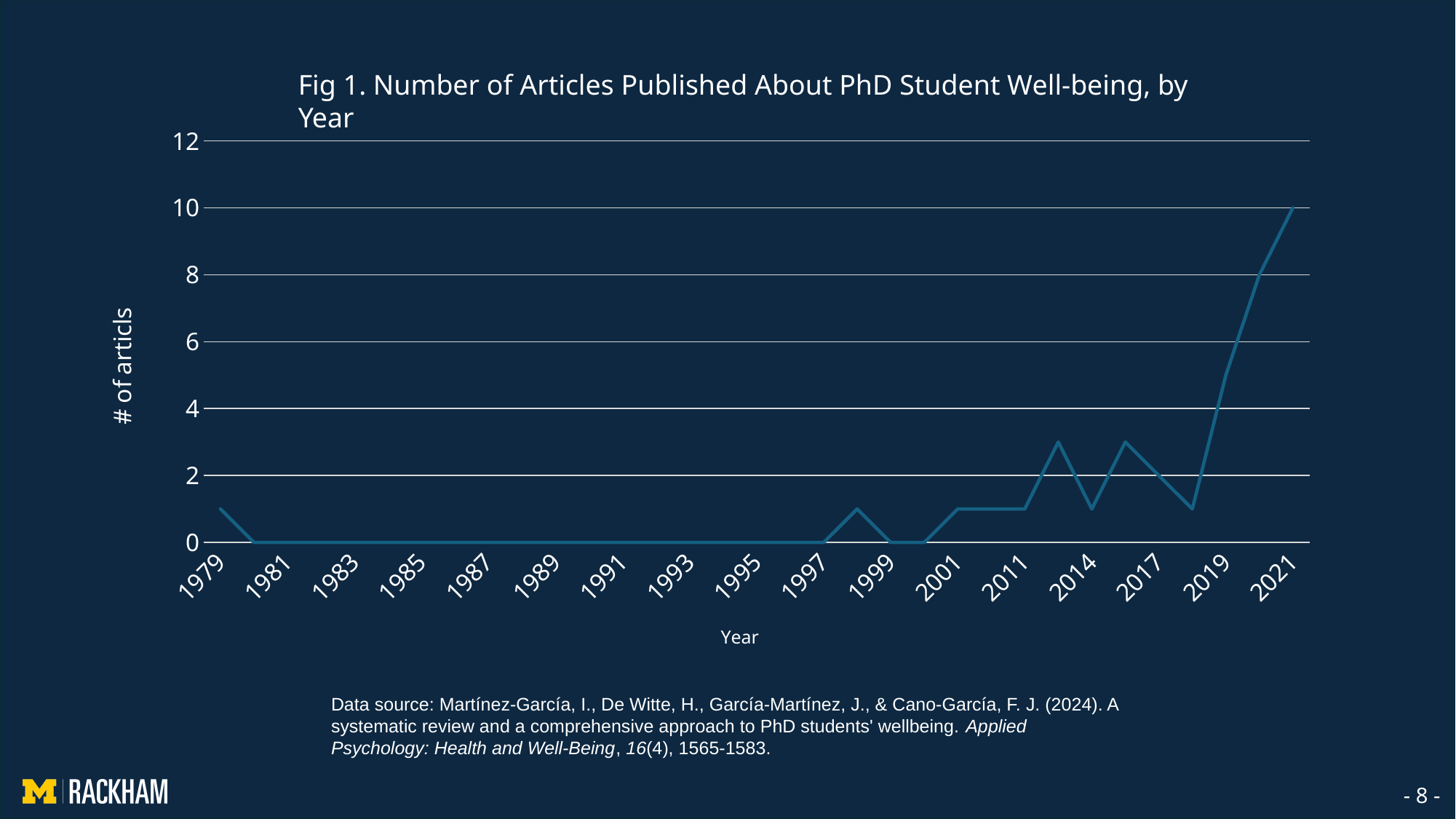
How many articles were published in 1991 according to the chart? 0 What kind of chart is shown on the slide? line chart What is the difference between the number of articles in 2021 and in 1981? 10 Which year has the larger value, 1979 or 2021? 2021 How many articles were published in 2021 according to the chart? 10 What is the label on the vertical axis of the chart? # of articls Is the value for 2021 greater or less than 8? greater Overall, does the number of articles rise or fall from 1979 to 2021? rise Is the value for 1979 greater or less than 2? less How many articles were published in 1981 according to the chart? 0 What is the title of the chart? Fig 1. Number of Articles Published About PhD Student Well-being, by Year Which year has the highest number of articles in the chart? 2021